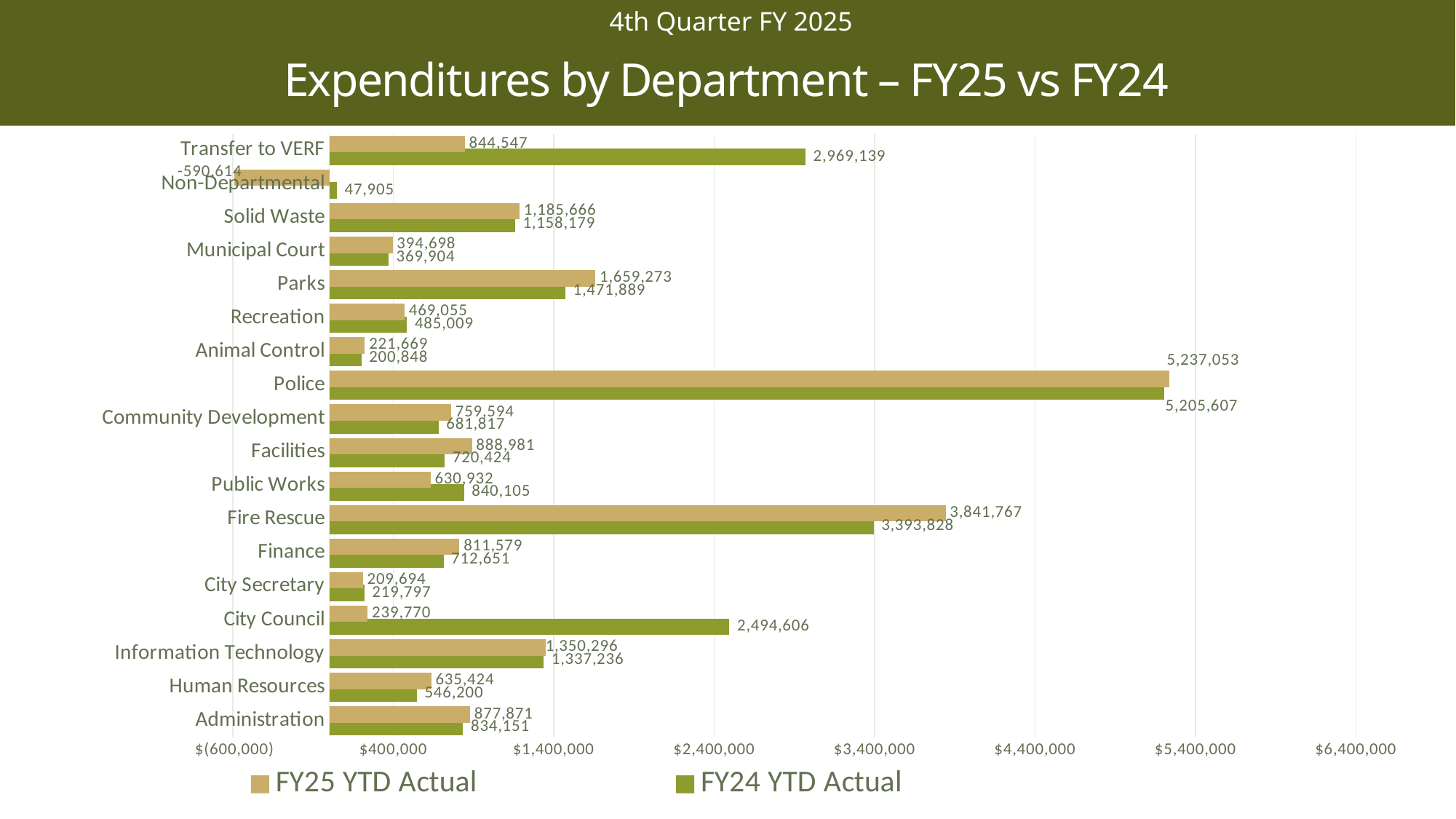
Which department has the highest FY25 YTD Actual expenditure? Police How many series does the legend list? 2 Which department has the lowest FY24 YTD Actual expenditure? Non-Departmental What kind of chart is shown on the slide? Bar chart What is the FY25 YTD Actual value for Non-Departmental? -590,614 What is the FY24 YTD Actual expenditure for City Council? 2,494,606 What is the difference between the FY25 and FY24 YTD Actual values for Fire Rescue? 447,939 Is the FY25 YTD Actual value for Police greater or less than $4,400,000? greater By how much does the FY24 YTD Actual for Transfer to VERF exceed the FY25 YTD Actual? 2,124,592 For Public Works, which is larger: the FY25 YTD Actual or the FY24 YTD Actual? FY24 YTD Actual How many departments are shown on the chart? 18 What is the FY25 YTD Actual expenditure for Fire Rescue? 3,841,767